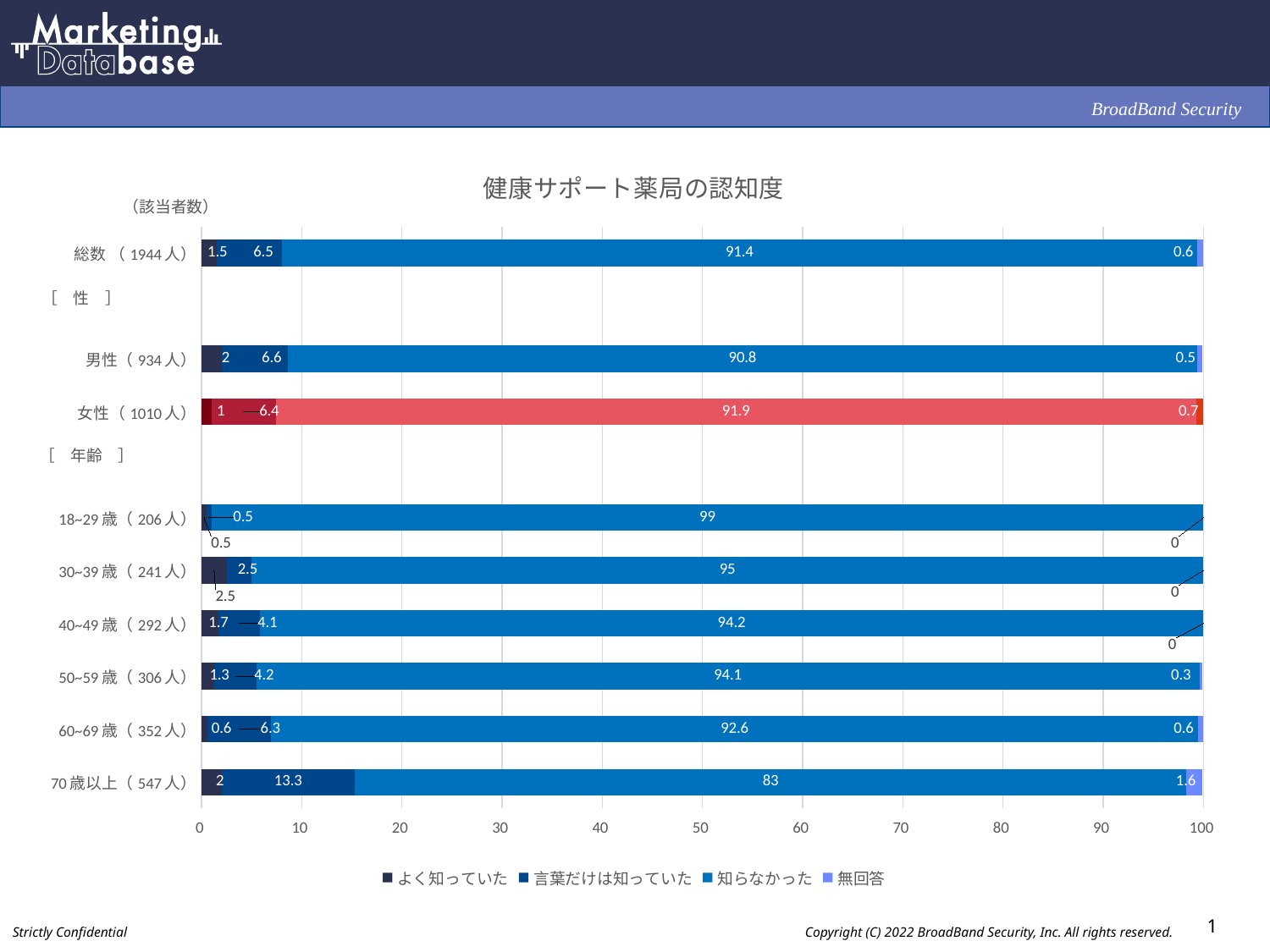
Which category has the lowest value for 知らなかった? 70歳以上 (547人) What is the value of 無回答 for 女性 (1010人)? 0.7 What type of chart is shown on the slide? Stacked bar chart How many age-group categories (under [年齢]) are plotted? 6 Which category has the highest value for 知らなかった? 18~29歳 (206人) What is the value of 言葉だけは知っていた for 70歳以上 (547人)? 13.3 What is the value of 知らなかった for 総数 (1944人)? 91.4 Is the 知らなかった value for 70歳以上 (547人) greater or less than 90? less Which is larger, the 言葉だけは知っていた value for 60~69歳 (352人) or for 50~59歳 (306人)? 60~69歳 (352人) What is the difference between the 知らなかった values for 男性 (934人) and 女性 (1010人)? 1.1 How many series does the legend list? 4 What is the chart's title? 健康サポート薬局の認知度